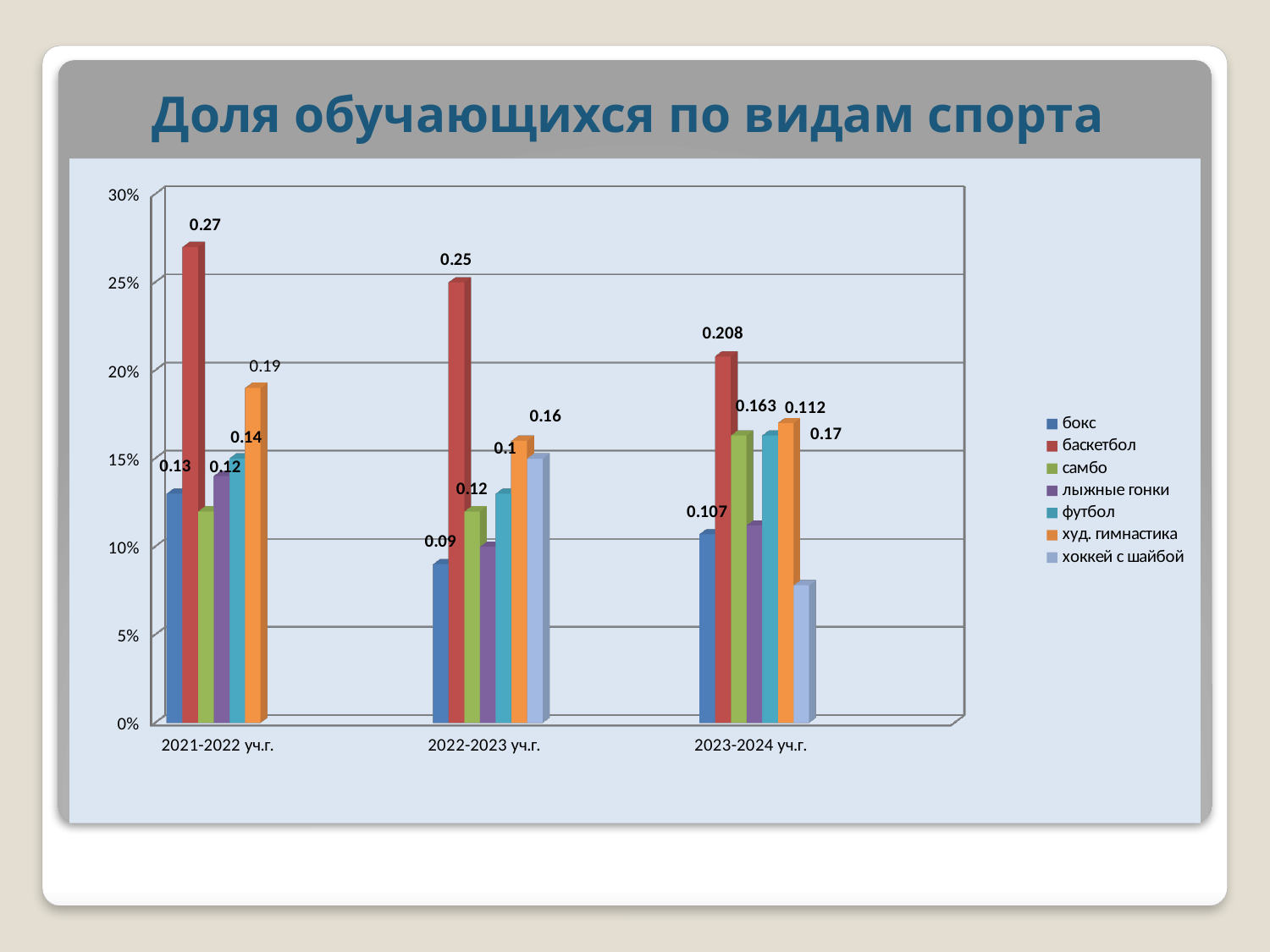
How many academic-year categories are shown on the x axis? 3 What kind of chart is shown on the slide? bar chart What is the value for баскетбол in 2021-2022 уч.г.? 0.27 What is the difference between the баскетбол values for 2021-2022 уч.г. and 2022-2023 уч.г.? 0.02 What is the value for бокс in 2022-2023 уч.г.? 0.09 Does the value for баскетбол rise or fall from 2021-2022 уч.г. to 2023-2024 уч.г.? fall Which sport has the highest value in 2021-2022 уч.г.? баскетбол Is the value for хоккей с шайбой in 2023-2024 уч.г. greater or less than 10%? less Which is larger in 2022-2023 уч.г., баскетбол or бокс? баскетбол How many series does the legend list? 7 What is the value for баскетбол in 2023-2024 уч.г.? 0.208 What is the title of the chart? Доля обучающихся по видам спорта